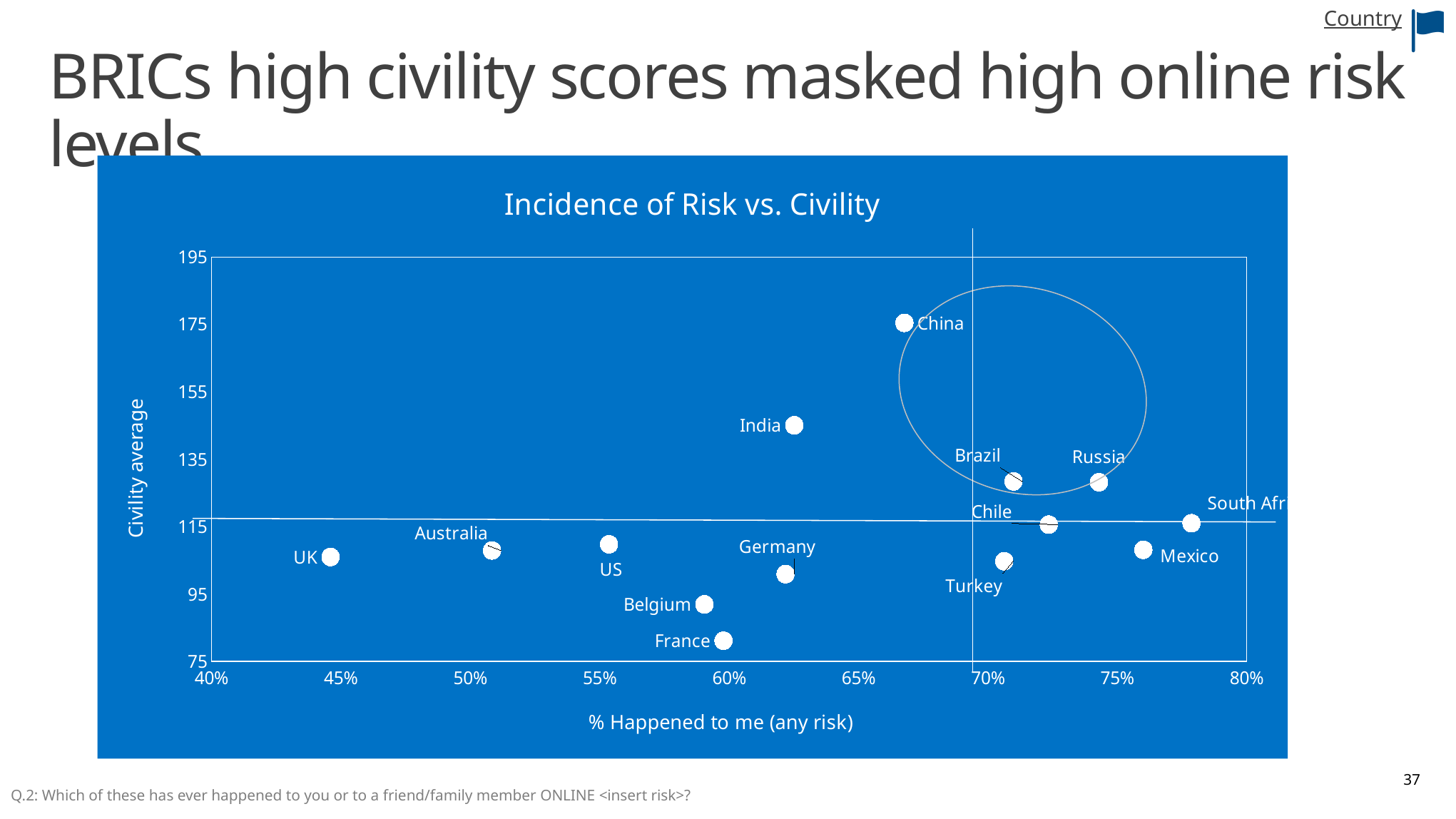
What kind of chart is shown on the slide? scatter chart Which country has the highest value for % Happened to me (any risk)? South Africa Which has a higher civility average, India or Germany? India Is the civility average for China greater or less than 155? greater How many countries are plotted on the chart? 14 Which country has the lowest value for % Happened to me (any risk)? UK Is the civility average for France greater or less than 95? less What is the title of the chart? Incidence of Risk vs. Civility What is the label of the vertical axis? Civility average Which country has the lowest civility average? France Is the % Happened to me value for UK greater or less than 50%? less Which country has the highest civility average? China